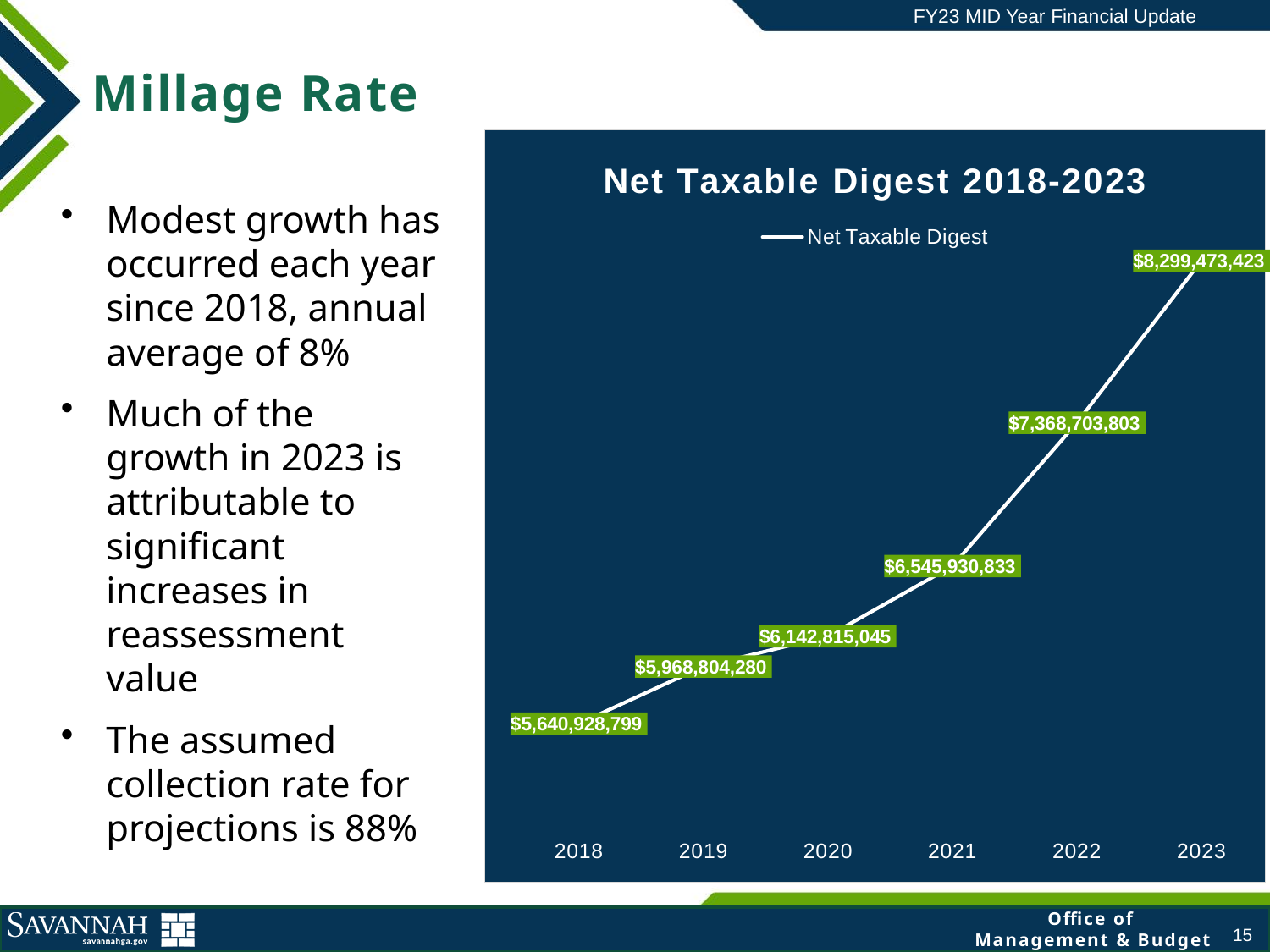
What is the Net Taxable Digest value for 2018? $5,640,928,799 Which year has the highest Net Taxable Digest? 2023 What is the difference between the Net Taxable Digest in 2023 and in 2022? $930,769,620 What is the Net Taxable Digest value for 2021? $6,545,930,833 Which year has the lowest Net Taxable Digest? 2018 How many series does the legend list? 1 Which is larger, the Net Taxable Digest in 2020 or in 2022? 2022 By how much did the Net Taxable Digest increase from 2018 to 2023? $2,658,544,624 Does the Net Taxable Digest rise or fall from 2018 to 2023? Rise What is the Net Taxable Digest value for 2023? $8,299,473,423 How many years are plotted on the Net Taxable Digest chart? 6 What kind of chart is shown on the slide? Line chart